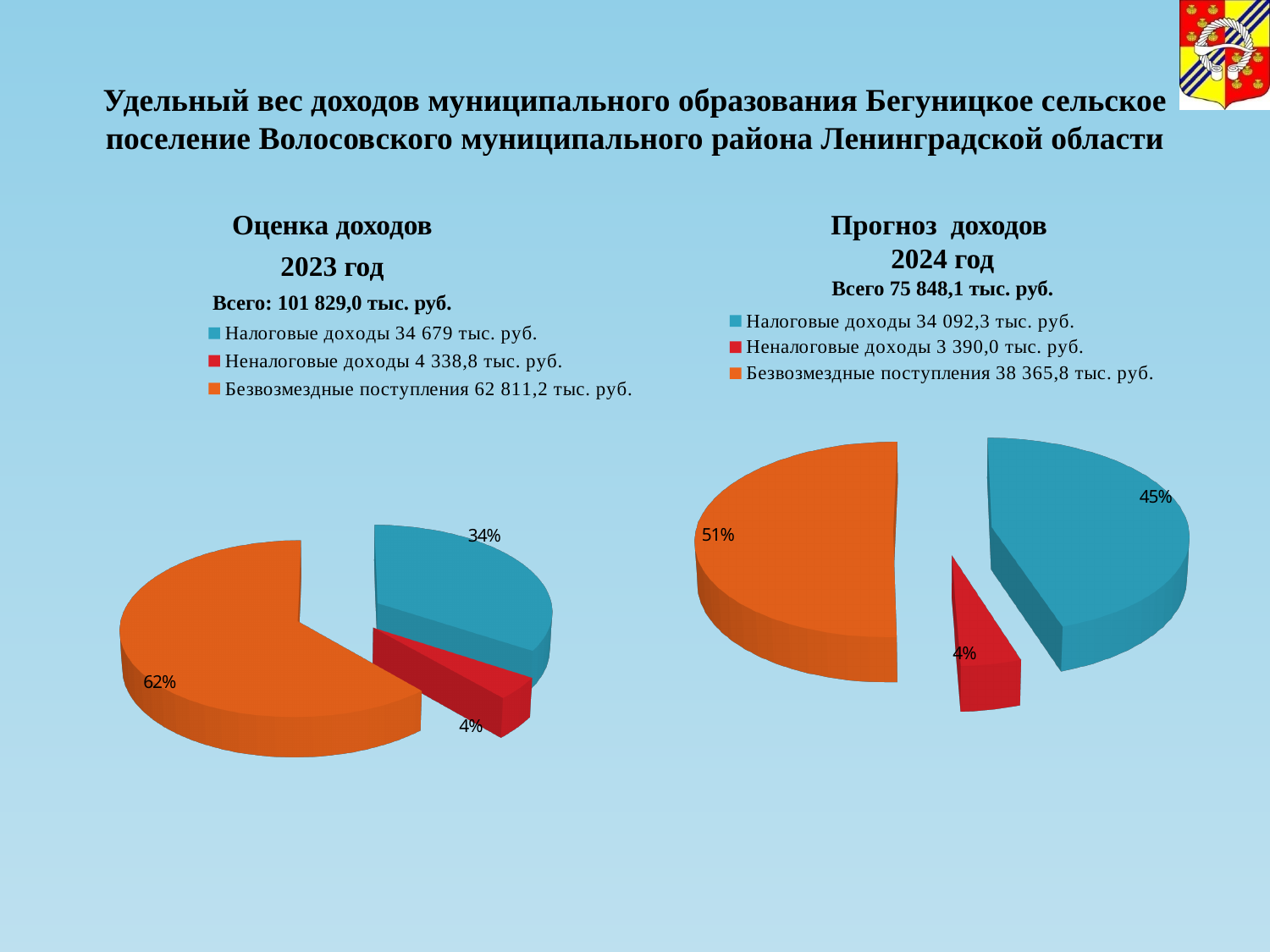
In the right chart (Прогноз доходов 2024 год), what share of the pie is Безвозмездные поступления? 51% In the left chart (Оценка доходов 2023 год), what colour is the Неналоговые доходы slice? red In the right chart (Прогноз доходов 2024 год), what is the difference in percentage points between Безвозмездные поступления and Налоговые доходы? 6 percentage points In the left chart (Оценка доходов 2023 год), which category has the smallest slice? Неналоговые доходы In the left chart (Оценка доходов 2023 год), what share of the pie is Налоговые доходы? 34% What kind of chart is used for the 2023 income estimate (left chart)? pie chart In the right chart (Прогноз доходов 2024 год), what share of the pie is Налоговые доходы? 45% In the left chart (Оценка доходов 2023 год), what is the difference in percentage points between Безвозмездные поступления and Налоговые доходы? 28 percentage points In the right chart (Прогноз доходов 2024 год), which category has the largest slice? Безвозмездные поступления How many slices does the right chart (Прогноз доходов 2024 год) have? 3 How many entries does the legend of the left chart (Оценка доходов 2023 год) list? 3